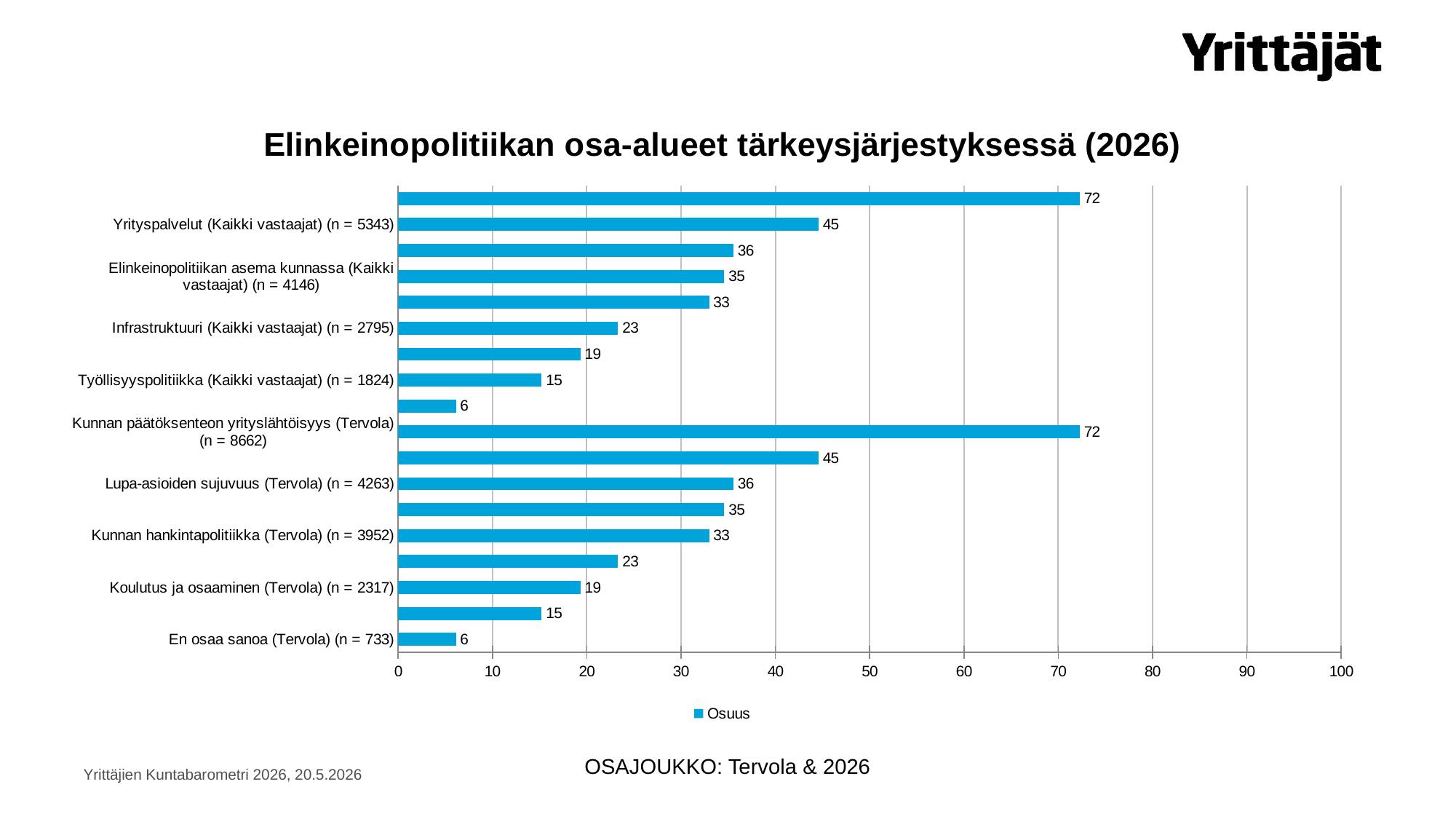
What is the name of the series shown in the legend? Osuus What type of chart is shown on the slide? bar chart How many bars are plotted in the chart? 18 What is the value for Kunnan päätöksenteon yrityslähtöisyys (Tervola) (n = 8662)? 72 How many series does the legend list? 1 What is the highest value shown on any bar in the chart? 72 Is the value for Koulutus ja osaaminen (Tervola) (n = 2317) greater or less than 30? less What is the difference between the highest bar value (72) and the lowest bar value (6)? 66 What is the lowest value shown on any bar in the chart? 6 What is the value for En osaa sanoa (Tervola) (n = 733)? 6 What is the title of the chart? Elinkeinopolitiikan osa-alueet tärkeysjärjestyksessä (2026) Which is larger, the value for Yrityspalvelut (Kaikki vastaajat) (n = 5343) or the value for Infrastruktuuri (Kaikki vastaajat) (n = 2795)? Yrityspalvelut (Kaikki vastaajat) (n = 5343)